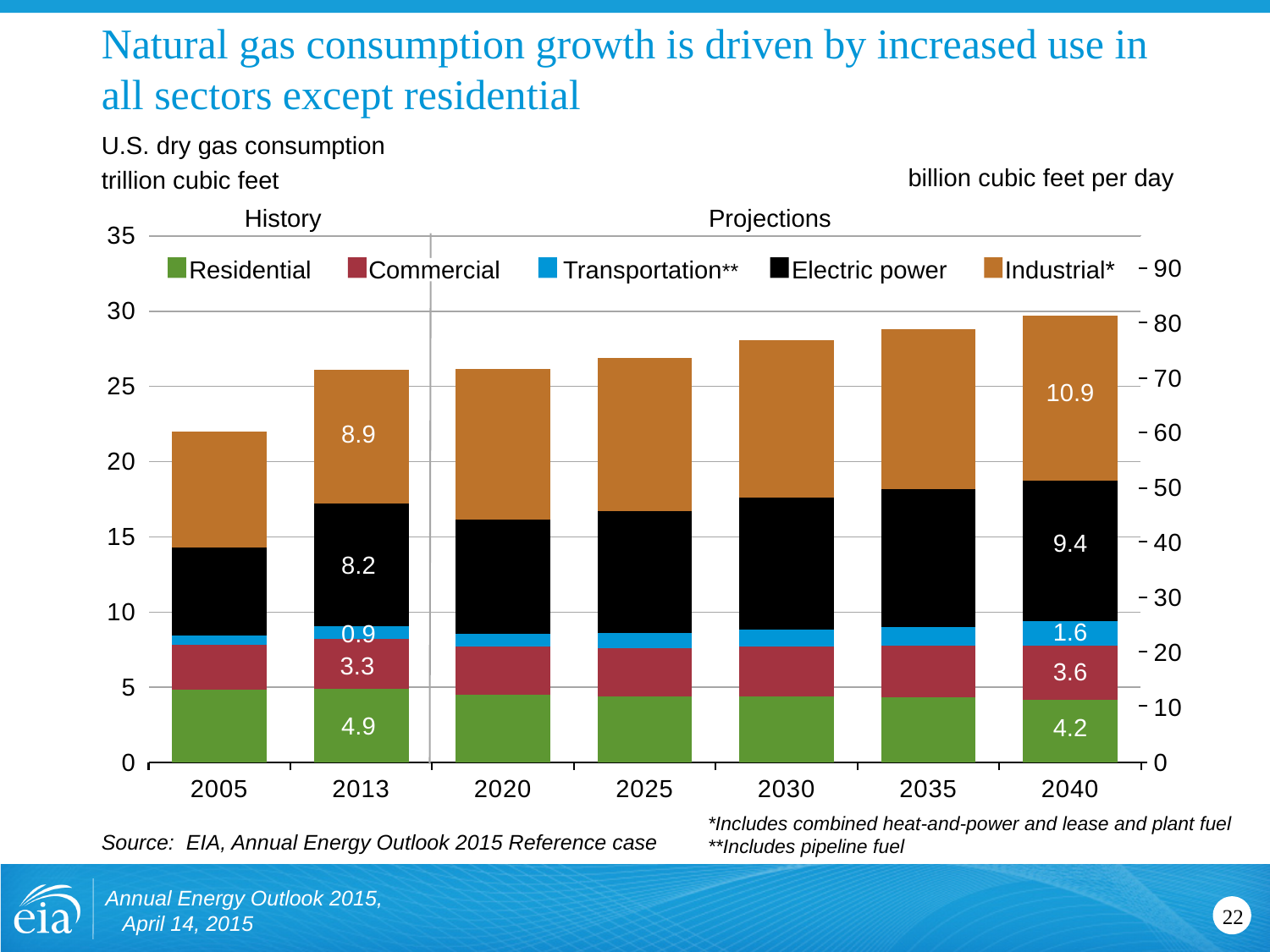
Is the total for 2005 greater or less than 25 trillion cubic feet? less What kind of chart is shown on the slide? stacked bar chart What is the Industrial value for 2040? 10.9 What is the Electric power value for 2013? 8.2 What is the total of the stacked bar for 2013? 26.2 How many series does the legend list? 5 What is the total of the stacked bar for 2040? 29.7 What is the Transportation value for 2040? 1.6 Which year has the lowest total consumption? 2005 How much larger is the Industrial value in 2040 than in 2013? 2.0 What is the Residential value for 2013? 4.9 How many years are shown along the x axis? 7